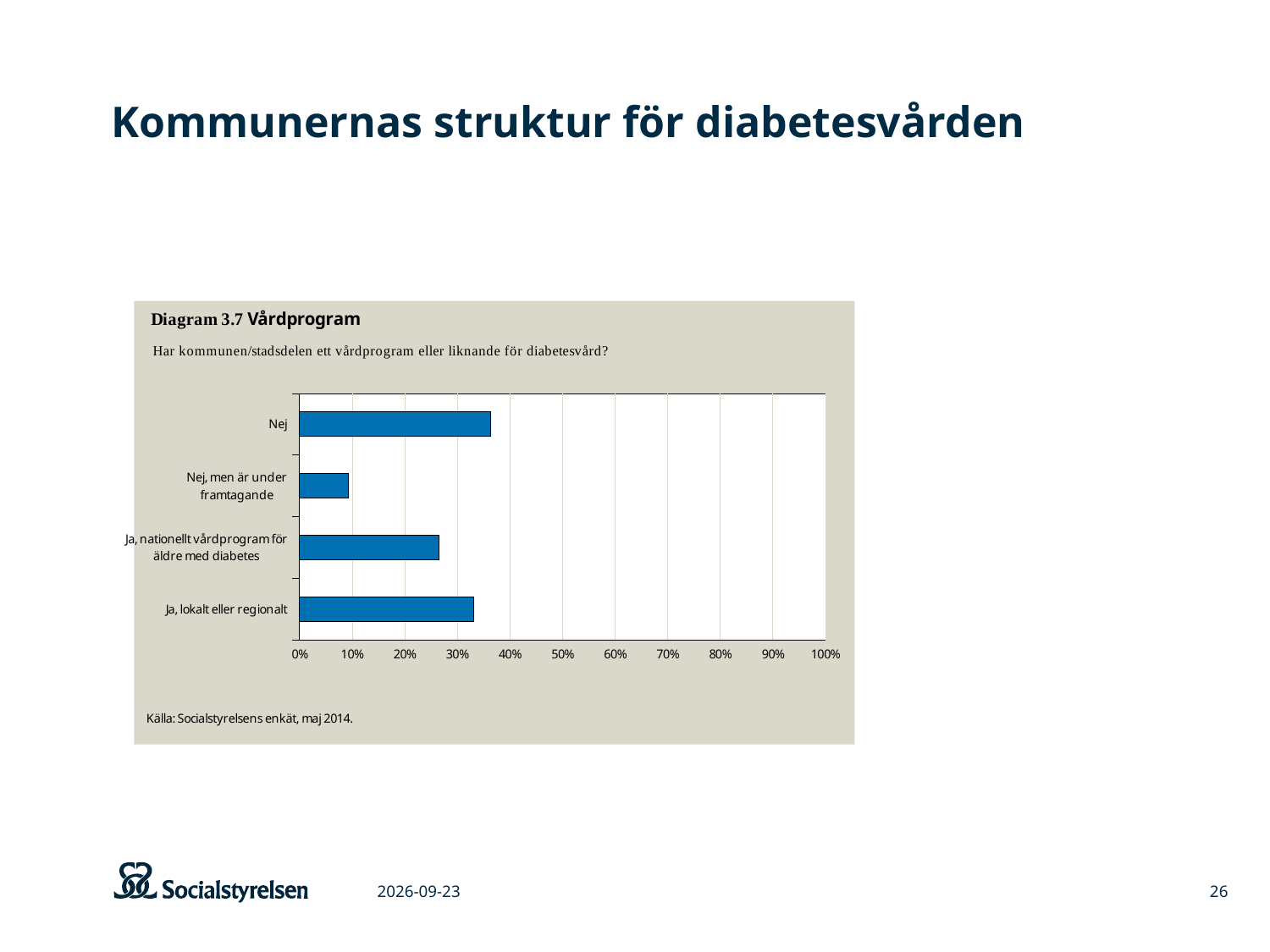
What kind of chart is shown in Diagram 3.7 Vårdprogram? bar chart Is the value for Ja, nationellt vårdprogram för äldre med diabetes greater or less than 20%? greater What is the title of the diagram on the slide? Diagram 3.7 Vårdprogram Which category has the lowest value in the chart? Nej, men är under framtagande Which is larger, the value for Ja, lokalt eller regionalt or the value for Nej, men är under framtagande? Ja, lokalt eller regionalt Which is larger, the value for Nej or the value for Ja, nationellt vårdprogram för äldre med diabetes? Nej Is the value for Ja, lokalt eller regionalt greater or less than 40%? less Which category has the highest value in the chart? Nej How many categories are plotted in the chart? 4 Is the value for Nej greater or less than 30%? greater What source is cited below the chart? Socialstyrelsens enkät, maj 2014